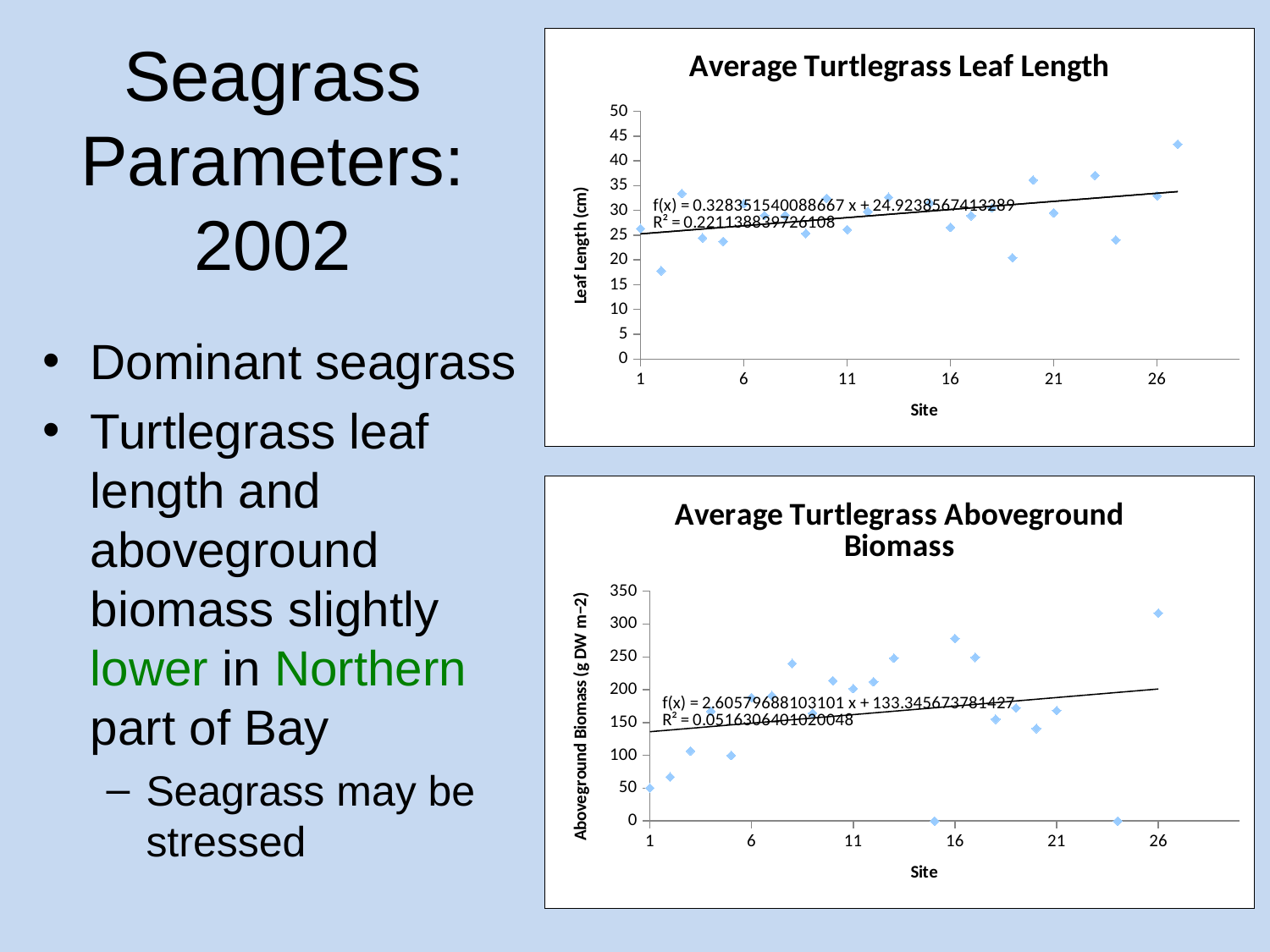
In the "Average Turtlegrass Leaf Length" chart, does the fitted trend line rise or fall as site number increases? rise In the "Average Turtlegrass Leaf Length" chart, is the value for site 27 greater or less than 40? greater In the "Average Turtlegrass Leaf Length" chart, is the value for site 2 greater or less than 20? less In the "Average Turtlegrass Leaf Length" chart, which is larger, the value for site 2 or the value for site 3? Site 3 What kind of chart is the "Average Turtlegrass Leaf Length" chart? scatter chart What is the y-axis label of the "Average Turtlegrass Aboveground Biomass" chart? Aboveground Biomass (g DW m−2) In the "Average Turtlegrass Aboveground Biomass" chart, which site has the highest biomass? Site 26 In the "Average Turtlegrass Aboveground Biomass" chart, is the value for site 8 greater or less than 200? greater In the "Average Turtlegrass Aboveground Biomass" chart, which is larger, the value for site 1 or the value for site 13? Site 13 In the "Average Turtlegrass Leaf Length" chart, which site has the lowest leaf length? Site 2 In the "Average Turtlegrass Leaf Length" chart, which site has the highest leaf length? Site 27